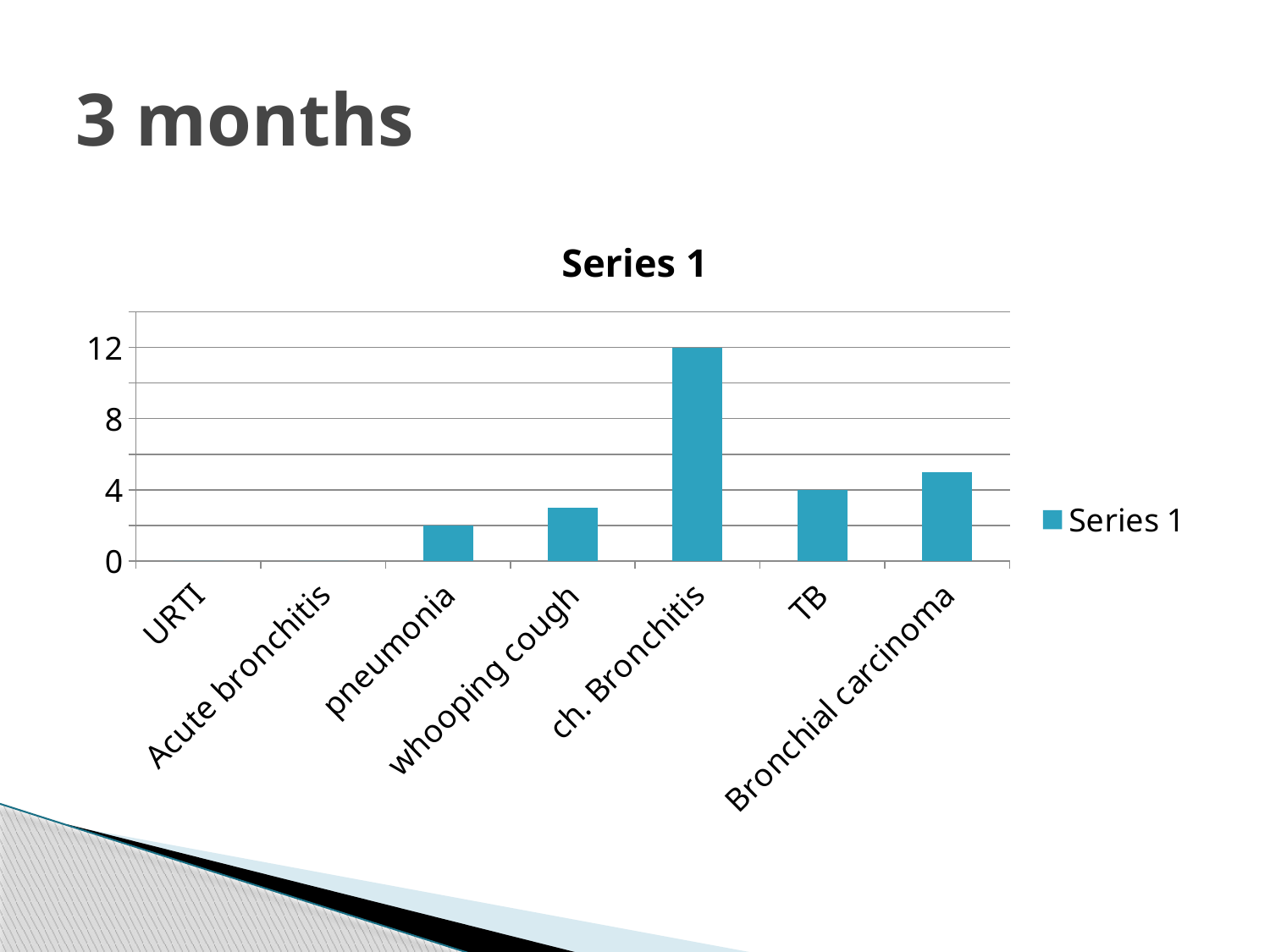
How many categories are shown on the x axis? 7 What is the value for TB? 4 Is the value for pneumonia greater or less than 4? less What kind of chart is shown on the slide? bar chart What is the title of the chart? Series 1 Is the value for whooping cough greater or less than 4? less How many series does the legend list? 1 What is the difference between the values for ch. Bronchitis and TB? 8 Is the value for Bronchial carcinoma greater or less than 4? greater Which is larger, the value for ch. Bronchitis or the value for Bronchial carcinoma? ch. Bronchitis What is the value for ch. Bronchitis? 12 Which category has the highest value? ch. Bronchitis